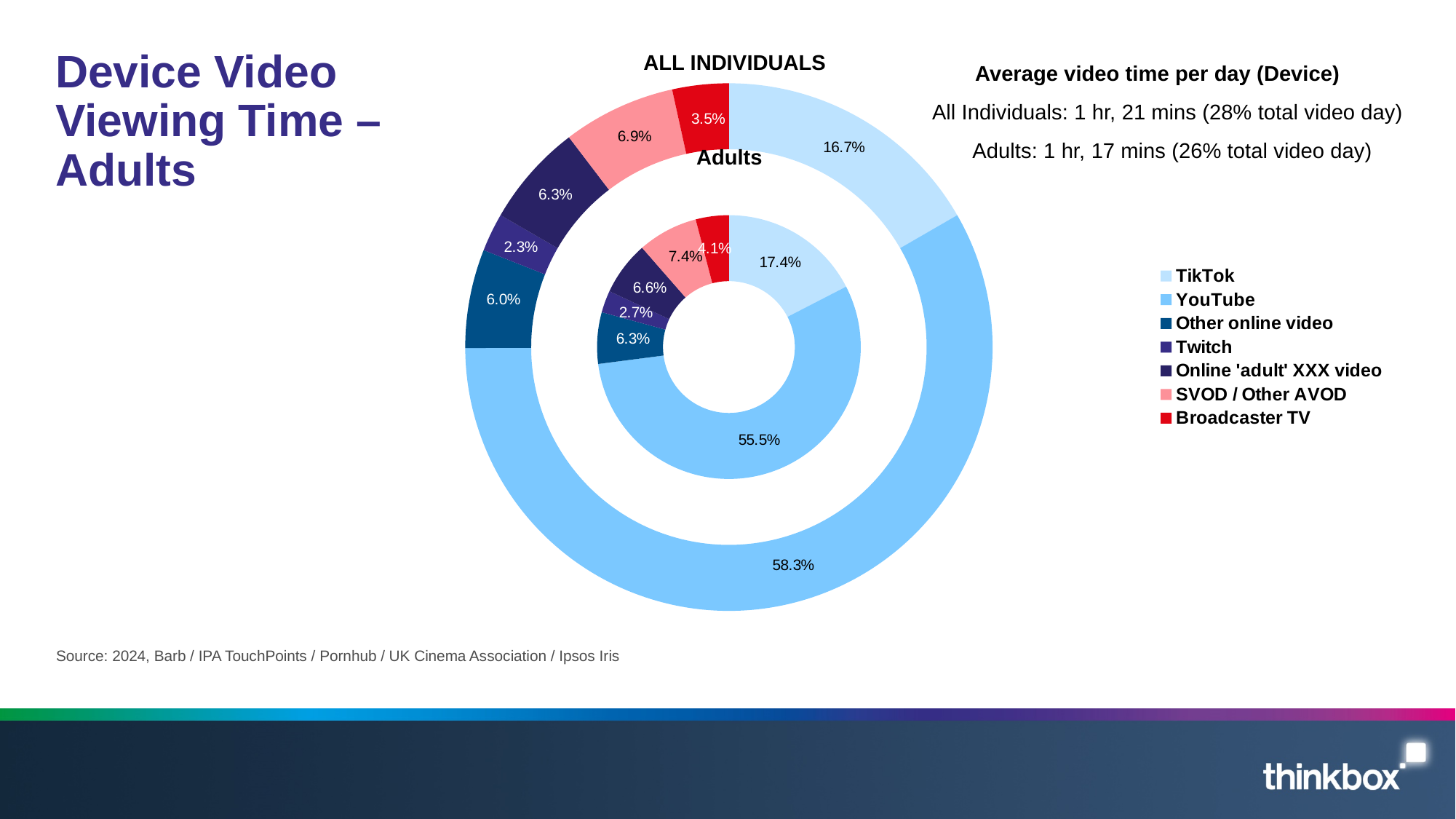
According to the text on the slide, what is the average device video time per day for Adults? 1 hr, 17 mins What type of chart is shown on the slide? Doughnut chart In the ALL INDIVIDUALS ring, what share does SVOD / Other AVOD have? 6.9% Which category has the smallest share in the Adults ring? Twitch In the Adults ring, what share does Twitch have? 2.7% How many categories does the legend list? 7 Is the Broadcaster TV share larger for ALL INDIVIDUALS or for Adults? Adults In the ALL INDIVIDUALS ring, what share does YouTube have? 58.3% Which category has the largest share in the ALL INDIVIDUALS ring? YouTube In the Adults ring, what share does TikTok have? 17.4% In the Adults ring, what share does Broadcaster TV have? 4.1% What is the difference between the YouTube share for ALL INDIVIDUALS and for Adults? 2.8 percentage points